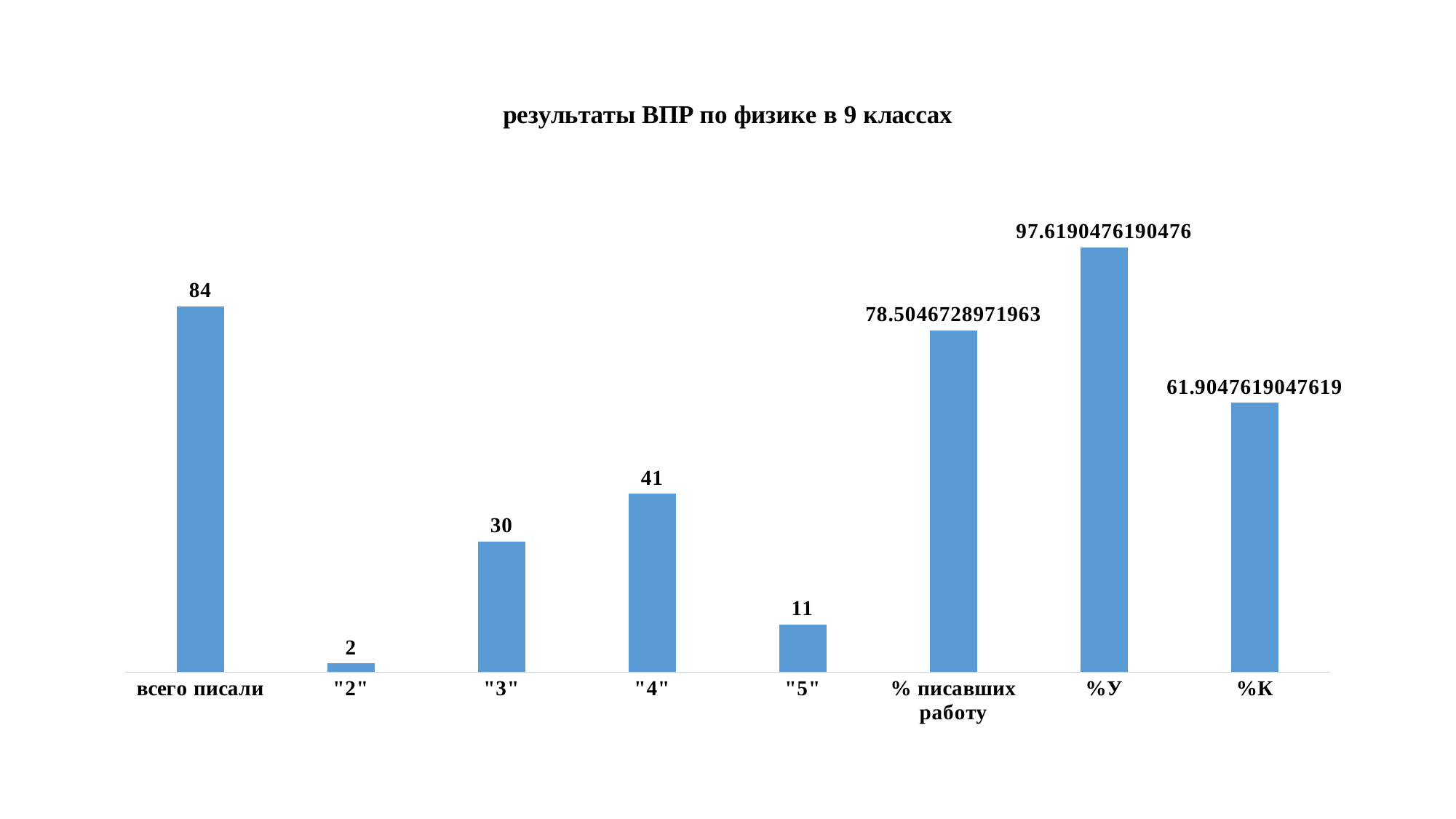
What is the title of the chart? результаты ВПР по физике в 9 классах Which is larger, the value for "3" or the value for "5"? "3" Which category has the lowest value? "2" Which category has the highest value? %У What is the difference between the values for "4" and "3"? 11 What is the value for "всего писали"? 84 What is the value for "% писавших работу"? 78.5046728971963 What is the value for "%У"? 97.6190476190476 How many categories are shown on the x axis? 8 What is the value for "%К"? 61.9047619047619 What is the value for "4"? 41 What kind of chart is this? bar chart